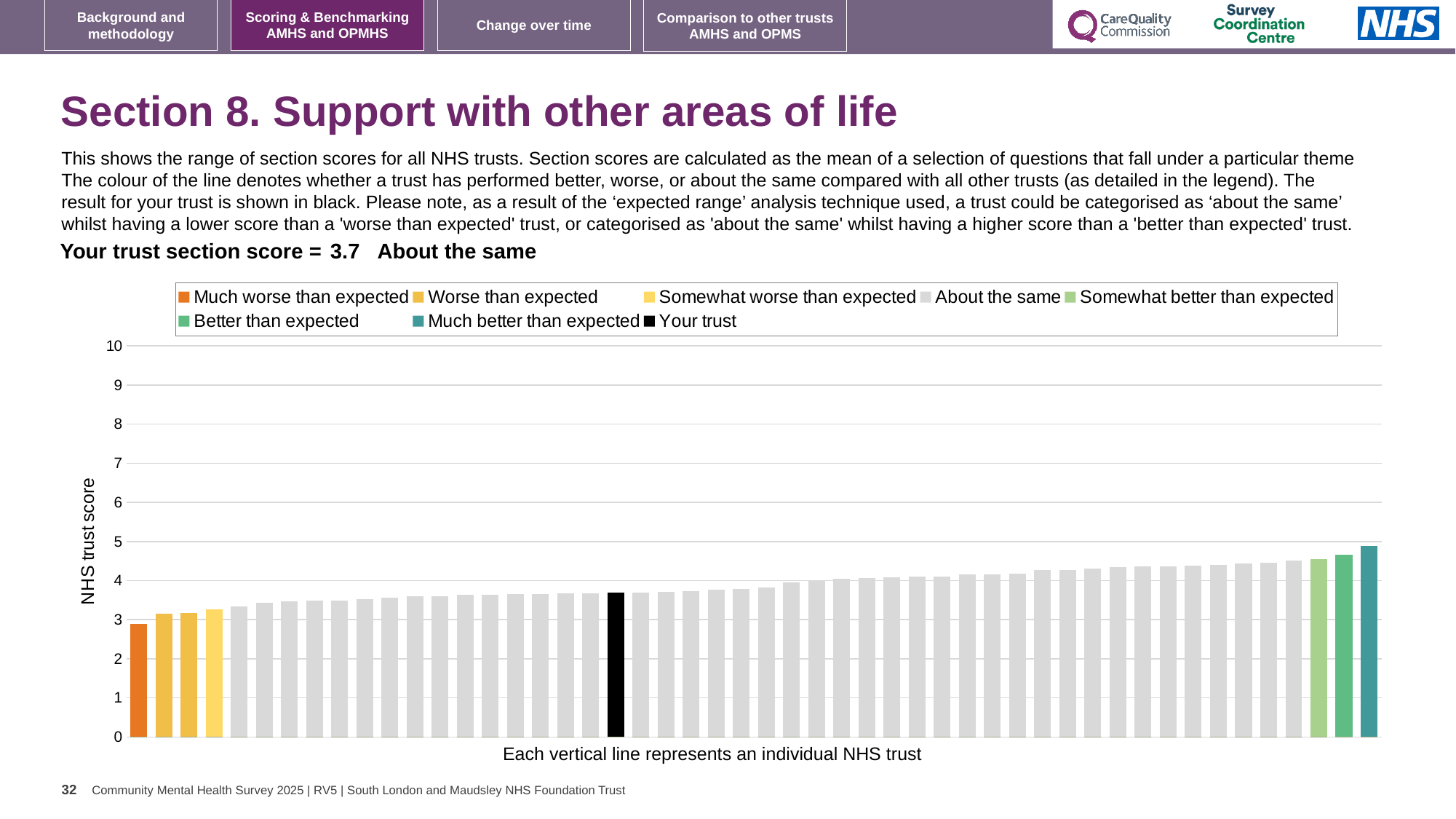
What kind of chart is shown on the slide? bar chart Is the value for your trust (the black bar) greater or less than 3? greater Is the value for your trust (the black bar) greater or less than 4? less Which category is your trust's section score placed in? About the same Do the bar values rise or fall from left to right along the x axis? rise What is the section score for your trust? 3.7 How many bars are coloured orange (Much worse than expected)? 1 Is the shortest bar in the chart greater or less than 4? less How many entries does the chart legend list? 8 What is the label on the vertical axis of the chart? NHS trust score What colour does the legend use for 'Your trust'? black